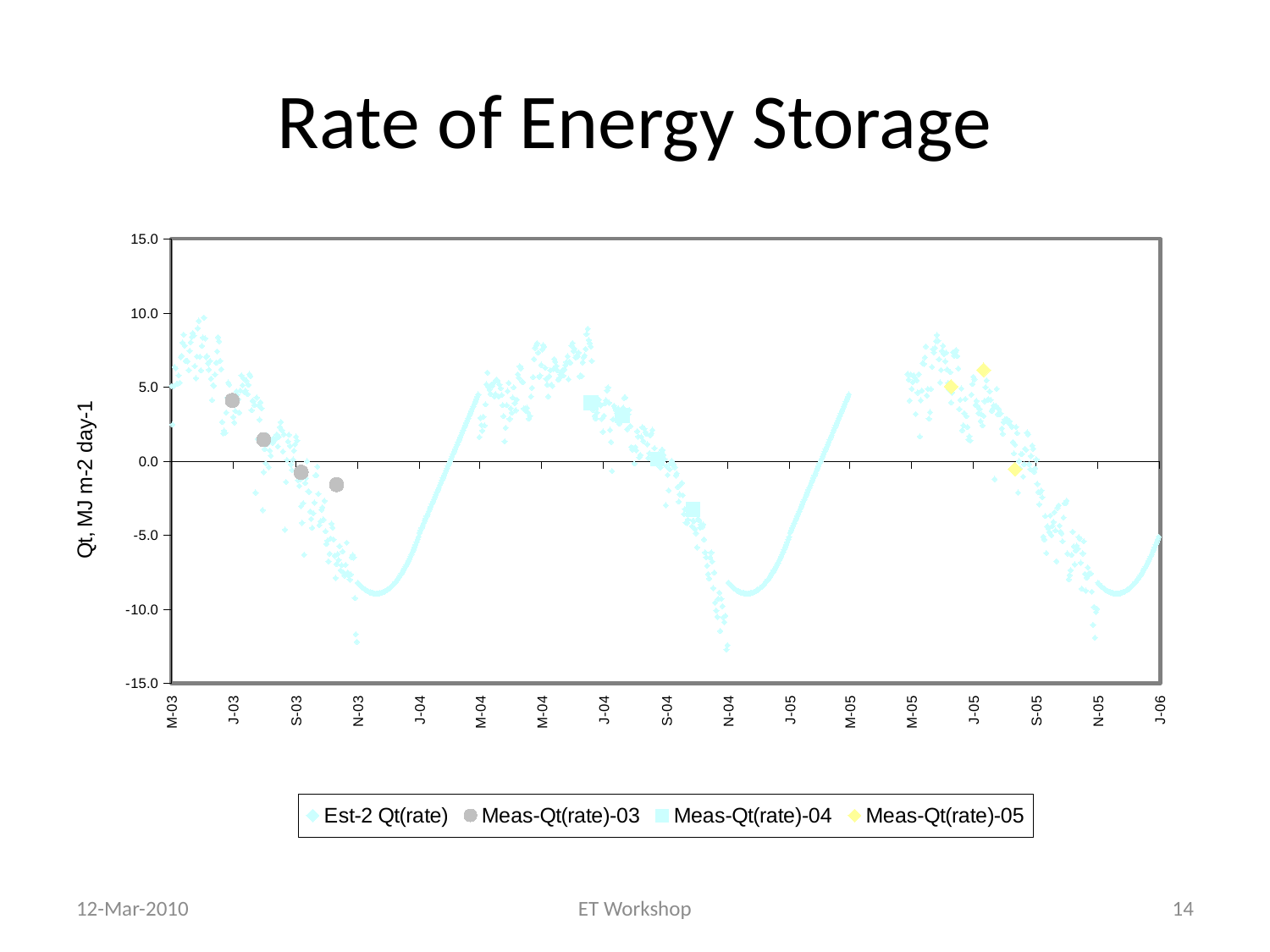
Which is larger: the first Meas-Qt(rate)-03 point near J-03 or the last Meas-Qt(rate)-03 point before N-03? The first point near J-03 Is the highest Meas-Qt(rate)-05 point (near J-05) greater or less than 5.0? greater How many series does the legend list? 4 Is the first Meas-Qt(rate)-03 point (near J-03) greater or less than 0.0? greater What colour are the markers for the Meas-Qt(rate)-05 series? Yellow How many Meas-Qt(rate)-03 points are plotted on the chart? 4 Do the Est-2 Qt(rate) values rise or fall between M-03 and N-03? Fall How many Meas-Qt(rate)-05 points are plotted on the chart? 3 Is the last Meas-Qt(rate)-03 point (between S-03 and N-03) greater or less than 0.0? less What kind of chart is shown on the slide? Scatter chart What is the label on the vertical axis of the chart? Qt, MJ m-2 day-1 What is the maximum value shown on the vertical axis? 15.0